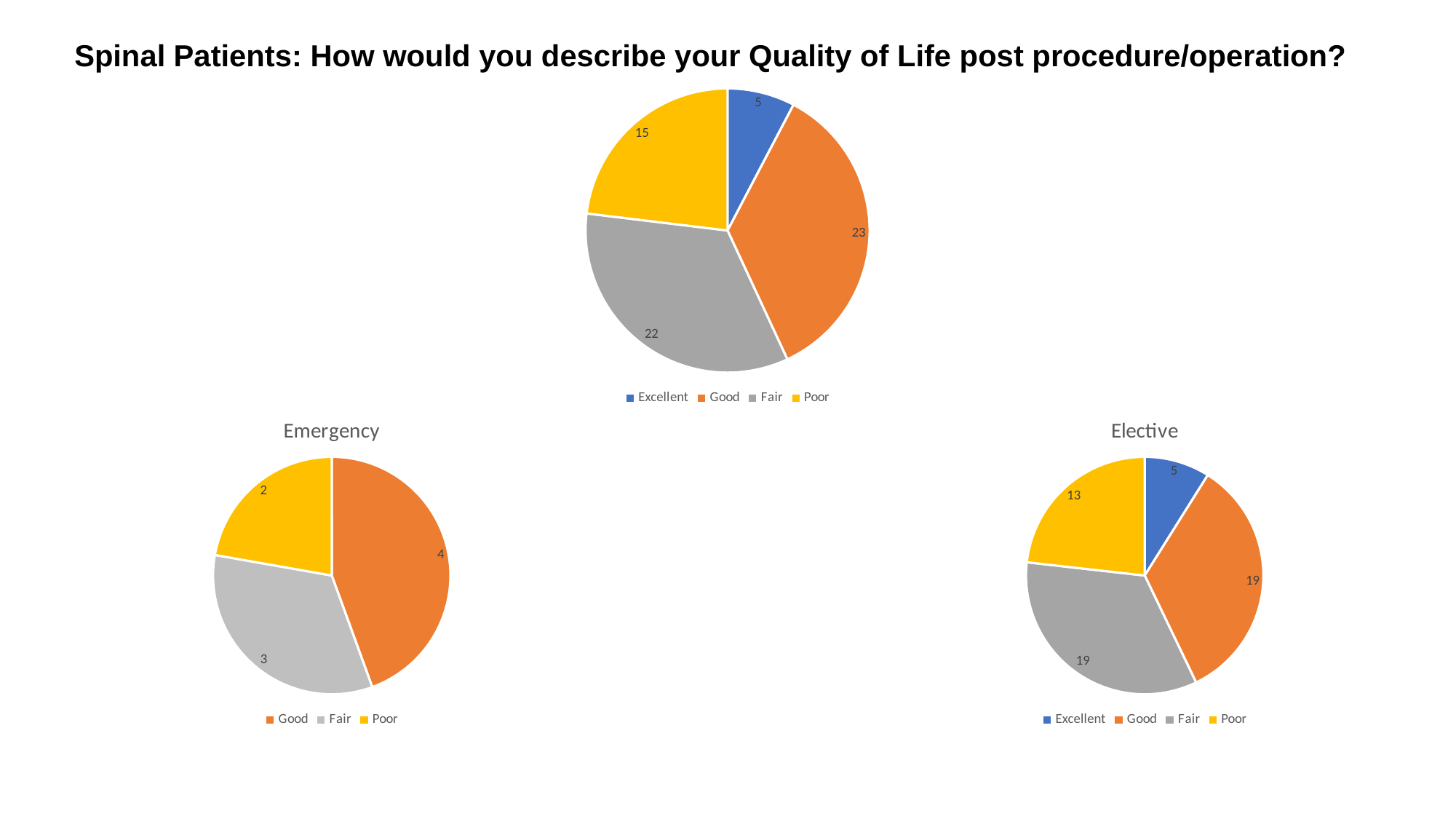
In the top pie chart, which category has the lowest value? Excellent In the Elective chart, which category has the lowest value? Excellent In the Emergency chart, what is the value for Fair? 3 In the Elective chart, what is the value for Poor? 13 In the Emergency chart, which category has the highest value? Good In the top pie chart, what is the difference between Good and Poor? 8 In the top pie chart, what is the value for Fair? 22 How many categories does the Emergency chart's legend list? 3 In the Elective chart, what colour represents Fair? grey What kind of chart is the Emergency chart? pie chart In the top pie chart, what is the value for Good? 23 In the Elective chart, which is larger, Good or Poor? Good